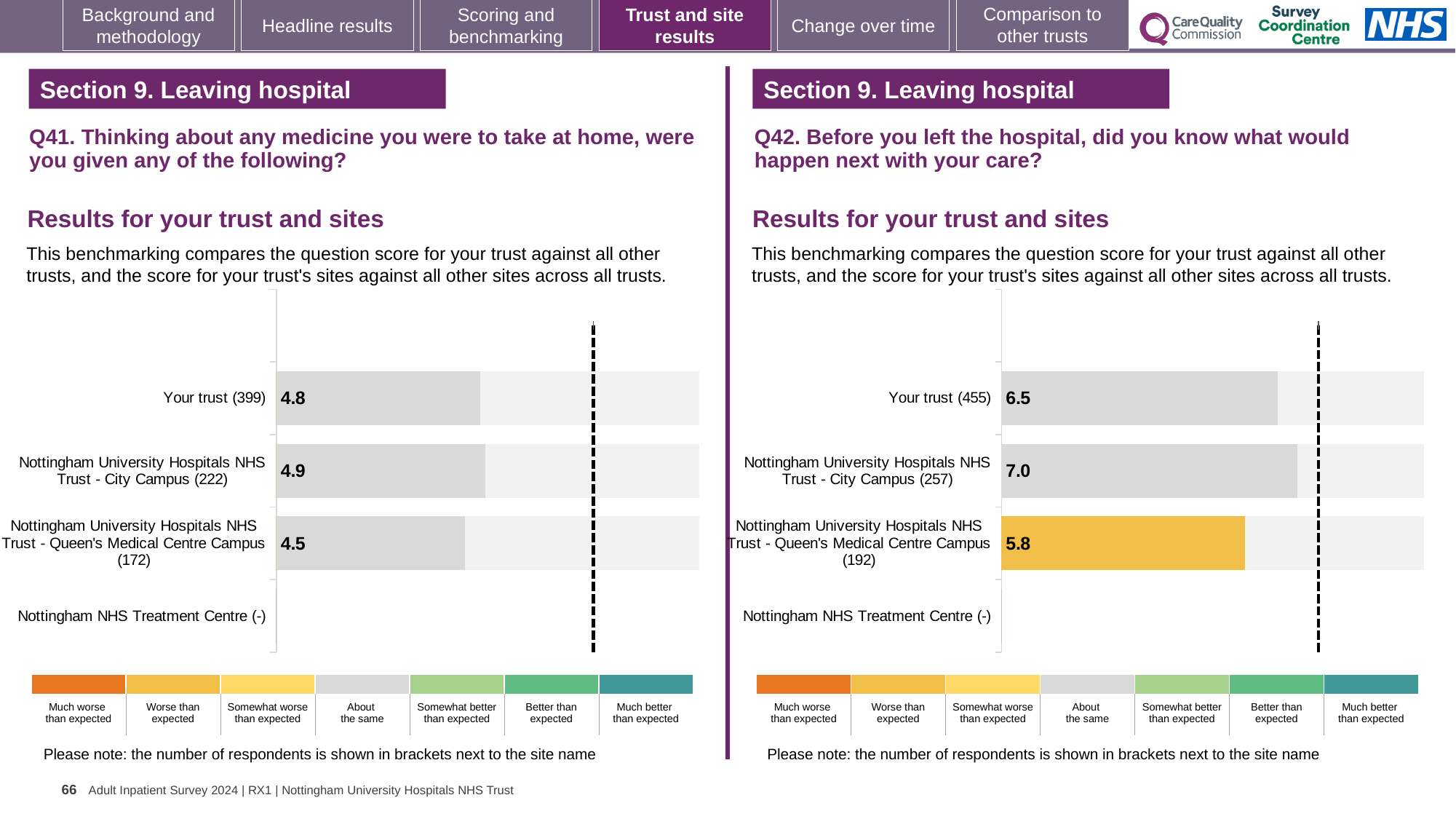
On the Q41 chart (left), what is the score for Nottingham University Hospitals NHS Trust - Queen's Medical Centre Campus (172)? 4.5 On the Q42 chart (right), what is the score for Nottingham University Hospitals NHS Trust - Queen's Medical Centre Campus (192)? 5.8 On the Q42 chart (right), what is the difference between the City Campus score and the Queen's Medical Centre Campus score? 1.2 On the Q41 chart (left), what is the difference between the City Campus score and the Queen's Medical Centre Campus score? 0.4 On the Q42 chart (right), which benchmark category does the colour of the Queen's Medical Centre Campus bar correspond to? Worse than expected On the Q42 chart (right), what is the score for Your trust (455)? 6.5 On the Q42 chart (right), which is larger: the score for Your trust (455) or the score for City Campus (257)? City Campus (257) On the Q41 chart (left), what is the score for Your trust (399)? 4.8 On the Q42 chart (right), which site has the highest score? Nottingham University Hospitals NHS Trust - City Campus (257) What kind of chart is used on the Q41 chart (left)? Bar chart On the Q41 chart (left), which site has the lowest score? Nottingham University Hospitals NHS Trust - Queen's Medical Centre Campus (172) On the Q41 chart (left), what is the score for Nottingham University Hospitals NHS Trust - City Campus (222)? 4.9